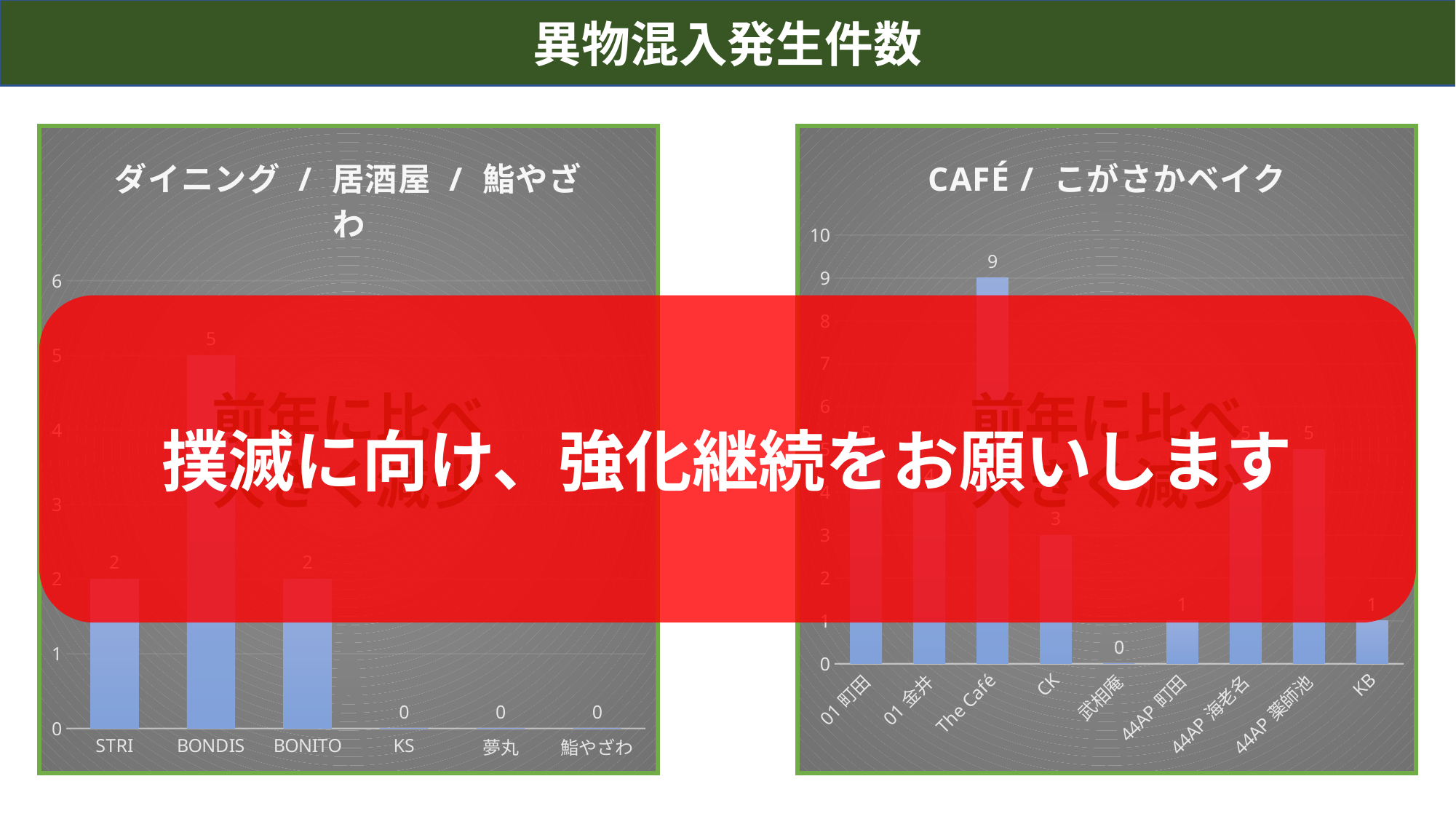
In the chart titled 'CAFÉ / こがさかベイク', what is the value for The Café? 9 In the chart titled 'CAFÉ / こがさかベイク', what is the value for CK? 3 In the chart titled 'ダイニング / 居酒屋 / 鮨やざわ', which is larger, the value for STRI or the value for BONDIS? BONDIS How many categories are shown on the x axis of the chart titled 'ダイニング / 居酒屋 / 鮨やざわ'? 6 In the chart titled 'CAFÉ / こがさかベイク', which category has the highest value? The Café In the chart titled 'CAFÉ / こがさかベイク', what is the value for 武相庵? 0 In the chart titled 'ダイニング / 居酒屋 / 鮨やざわ', what is the value for BONDIS? 5 In the chart titled 'ダイニング / 居酒屋 / 鮨やざわ', which category has the highest value? BONDIS In the chart titled 'ダイニング / 居酒屋 / 鮨やざわ', what is the value for STRI? 2 In the chart titled 'CAFÉ / こがさかベイク', is the value for 01 町田 greater or less than 2? greater In the chart titled 'CAFÉ / こがさかベイク', what is the difference between the values for The Café and CK? 6 What kind of chart is the chart titled 'CAFÉ / こがさかベイク'? bar chart